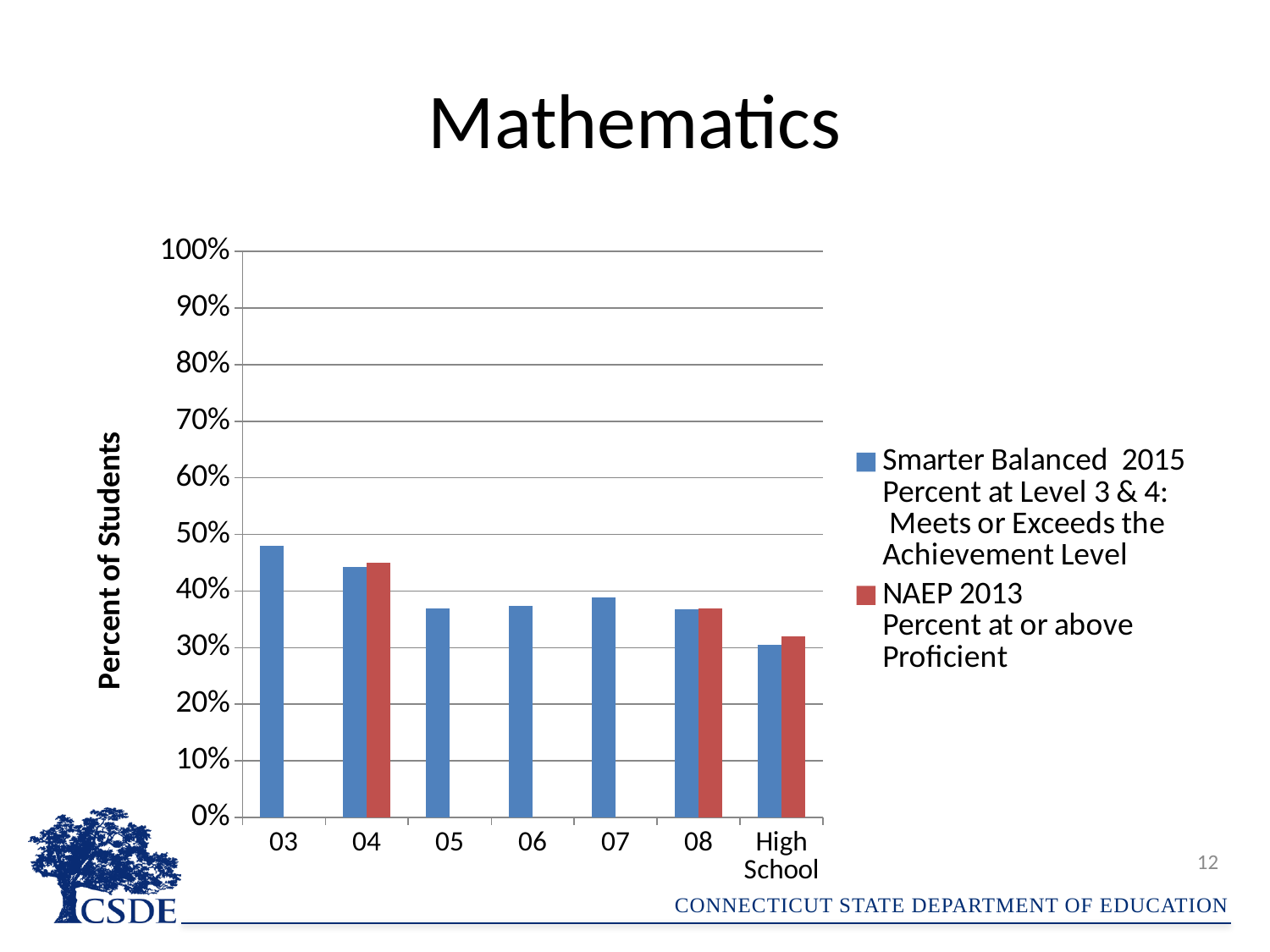
Is the Smarter Balanced 2015 value for grade 06 greater or less than 40%? less For High School, which is larger: the Smarter Balanced 2015 value or the NAEP 2013 value? NAEP 2013 How many categories are shown on the x axis? 7 What kind of chart is shown on the slide? bar chart Which grade has the highest Smarter Balanced 2015 value? 03 For which categories is a NAEP 2013 bar shown? 04, 08, High School What is the title of the chart? Mathematics How many series does the legend list? 2 Which category has the lowest Smarter Balanced 2015 value? High School Is the NAEP 2013 value for High School greater or less than 40%? less Is the Smarter Balanced 2015 value for grade 05 greater or less than 30%? greater